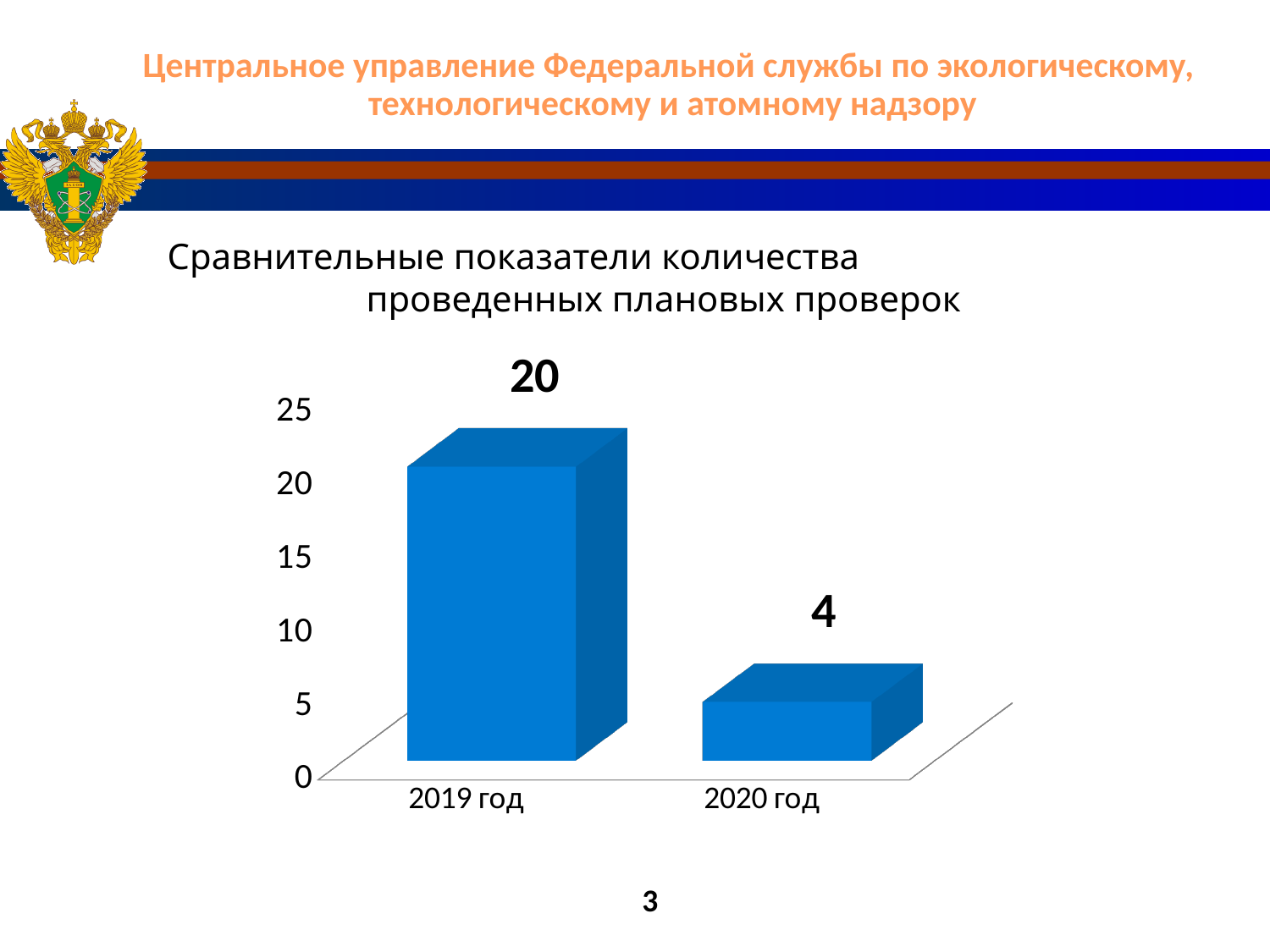
Is the value for 2019 год greater or less than 15? greater Which year has the highest value? 2019 год What is the title of the chart? Сравнительные показатели количества проведенных плановых проверок Which is larger, the value for 2019 год or the value for 2020 год? 2019 год What is the value for 2020 год? 4 Do the values rise or fall from 2019 год to 2020 год? fall What is the value for 2019 год? 20 How many categories are shown on the x axis? 2 What is the difference between the values for 2019 год and 2020 год? 16 Is the value for 2020 год greater or less than 5? less Which year has the lowest value? 2020 год What kind of chart is shown on the slide? bar chart